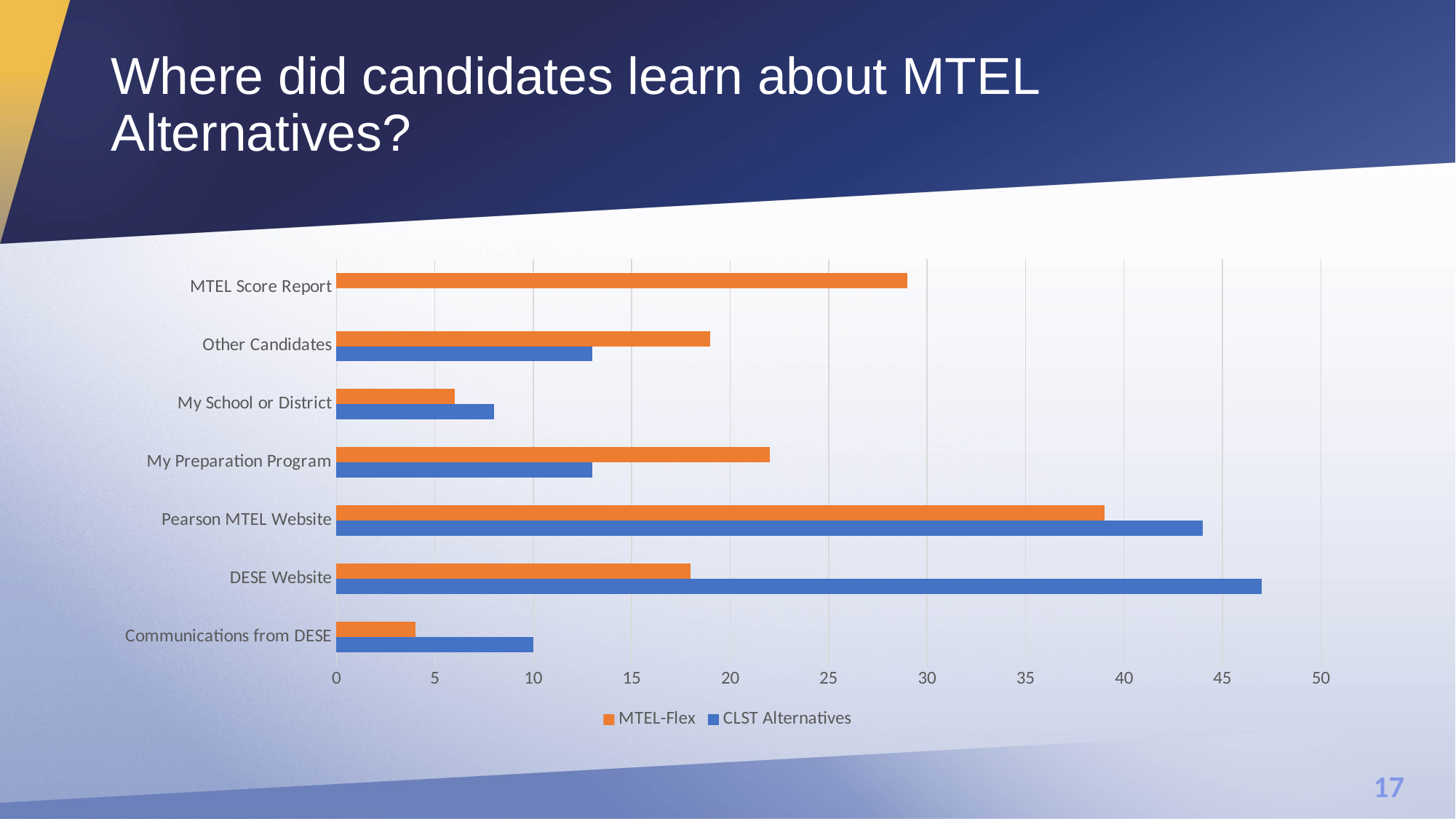
For My Preparation Program, which series has the larger value, MTEL-Flex or CLST Alternatives? MTEL-Flex Which colour represents the MTEL-Flex series in the chart? orange How many series does the legend list? 2 Which category has the highest MTEL-Flex value? Pearson MTEL Website Which category has the lowest MTEL-Flex value? Communications from DESE For DESE Website, which series has the larger value, MTEL-Flex or CLST Alternatives? CLST Alternatives What kind of chart is shown on the slide? bar chart Is the CLST Alternatives value for Pearson MTEL Website greater or less than 40? greater Is the MTEL-Flex value for MTEL Score Report greater or less than 25? greater How many categories are shown on the chart? 7 Which category has the highest CLST Alternatives value? DESE Website Is the MTEL-Flex value for DESE Website greater or less than 20? less